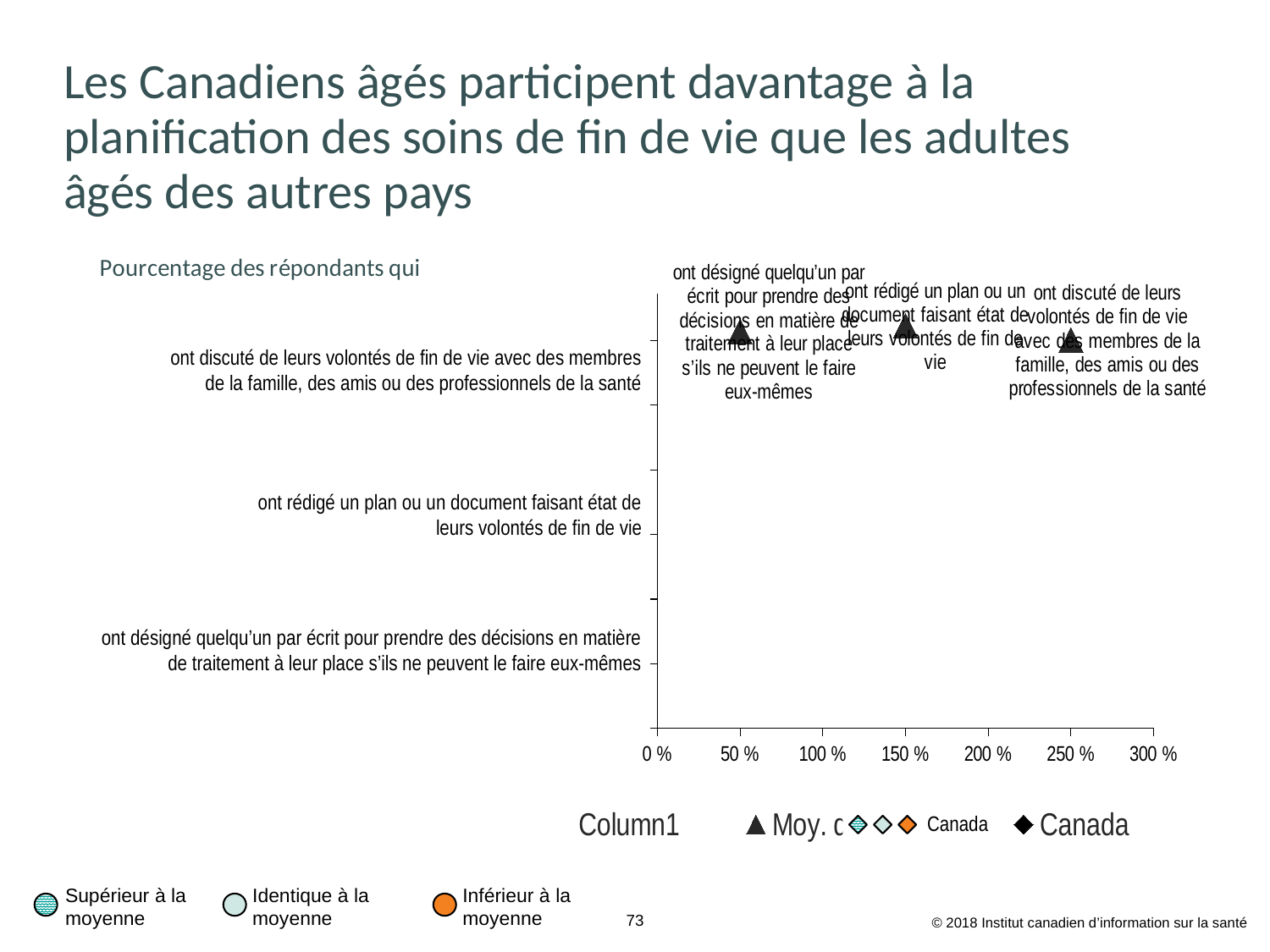
What subtitle appears above the chart describing what is plotted? Pourcentage des répondants qui Is the marker for 'ont rédigé un plan ou un document faisant état de leurs volontés de fin de vie' greater or less than 200 %? less Which marker is further right: 'ont rédigé un plan ou un document faisant état de leurs volontés de fin de vie' or 'ont désigné quelqu'un par écrit pour prendre des décisions en matière de traitement à leur place s'ils ne peuvent le faire eux-mêmes'? ont rédigé un plan ou un document faisant état de leurs volontés de fin de vie How many categories are listed on the vertical axis of the chart? 3 Which category has its marker furthest to the left on the chart? ont désigné quelqu'un par écrit pour prendre des décisions en matière de traitement à leur place s'ils ne peuvent le faire eux-mêmes Is the marker for 'ont rédigé un plan ou un document faisant état de leurs volontés de fin de vie' greater or less than 100 %? greater Which category has its marker furthest to the right on the chart? ont discuté de leurs volontés de fin de vie avec des membres de la famille, des amis ou des professionnels de la santé Is the marker for 'ont désigné quelqu'un par écrit pour prendre des décisions en matière de traitement à leur place s'ils ne peuvent le faire eux-mêmes' greater or less than 100 %? less What is the highest value shown on the horizontal axis of the chart? 300 %